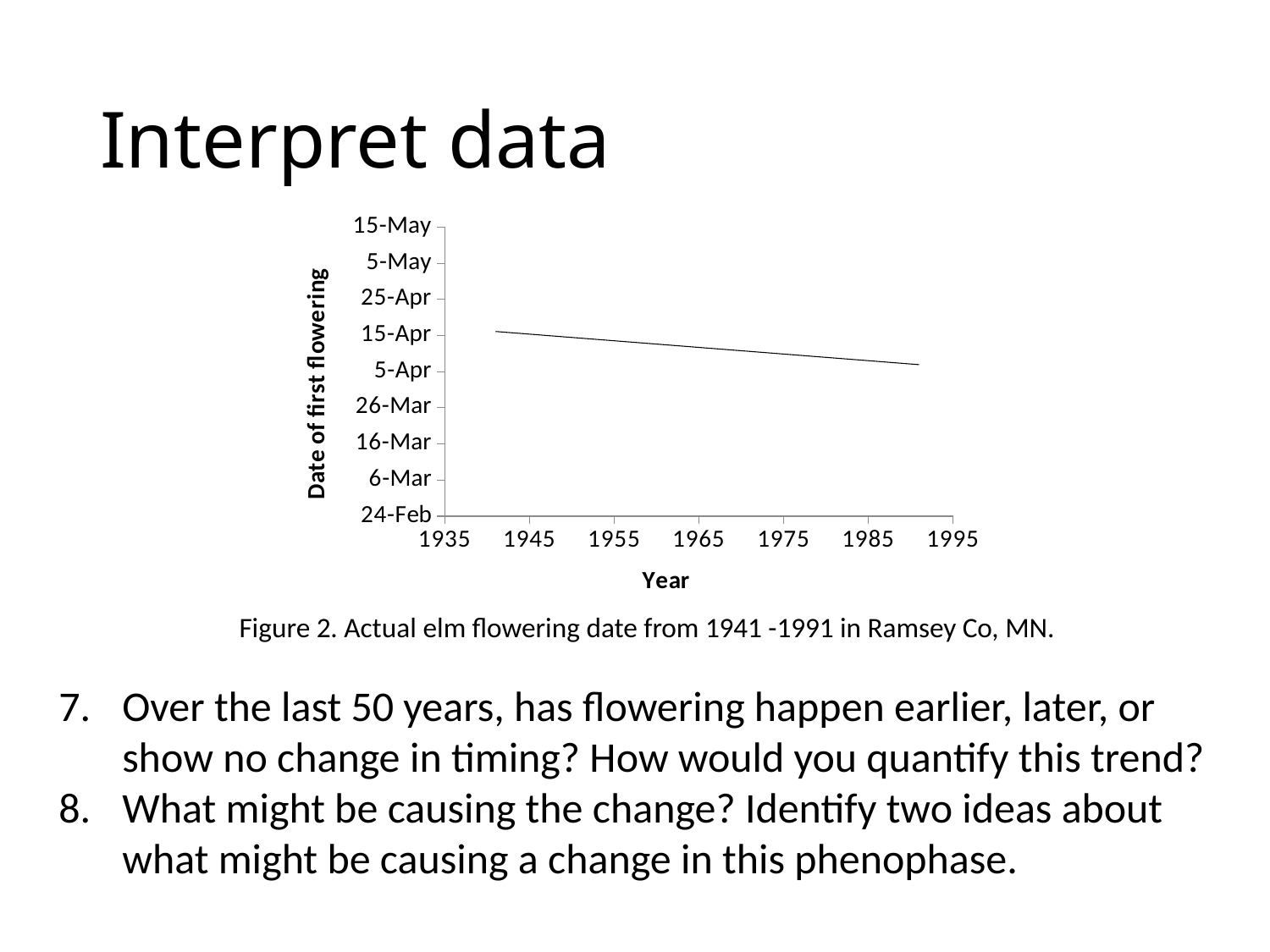
Does the date of first flowering rise or fall as the year increases along the x axis? fall Is the date of first flowering at the right end of the line (around 1991) earlier or later than 26-Mar? later According to the chart, does elm flowering happen earlier or later over the period shown? earlier Which end of the line shows the later date of first flowering, the 1941 end or the 1991 end? the 1941 end What is the title of the y axis of the chart? Date of first flowering Is the date of first flowering at the left end of the line (around 1941) earlier or later than 25-Apr? earlier Is the date of first flowering at the left end of the line (around 1941) earlier or later than 5-Apr? later What is the title of the x axis of the chart? Year What kind of chart is shown on the slide? line chart